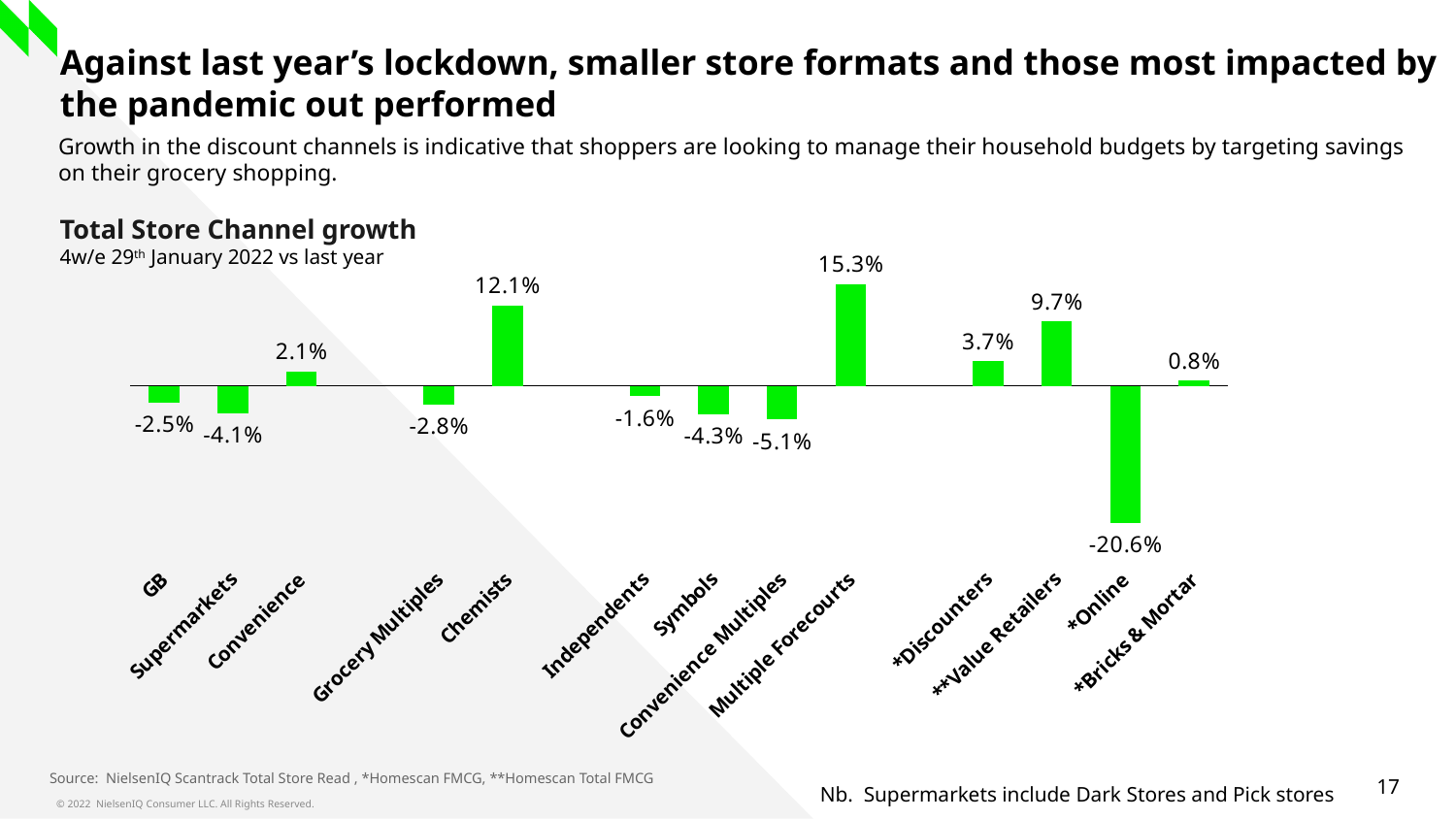
Which has lower growth, Symbols or Convenience Multiples? Convenience Multiples What is the growth value for Chemists? 12.1% How many channels are plotted in the chart? 13 Which channel has the highest growth? Multiple Forecourts What is the growth value for Discounters? 3.7% What is the difference between the growth for Multiple Forecourts and Value Retailers? 5.6 percentage points What type of chart is shown on the slide? Bar chart Which has higher growth, Convenience or Discounters? Discounters Which channel has the lowest growth? Online What is the growth value for Supermarkets? -4.1% What is the title of the chart? Total Store Channel growth What is the growth value for Online? -20.6%